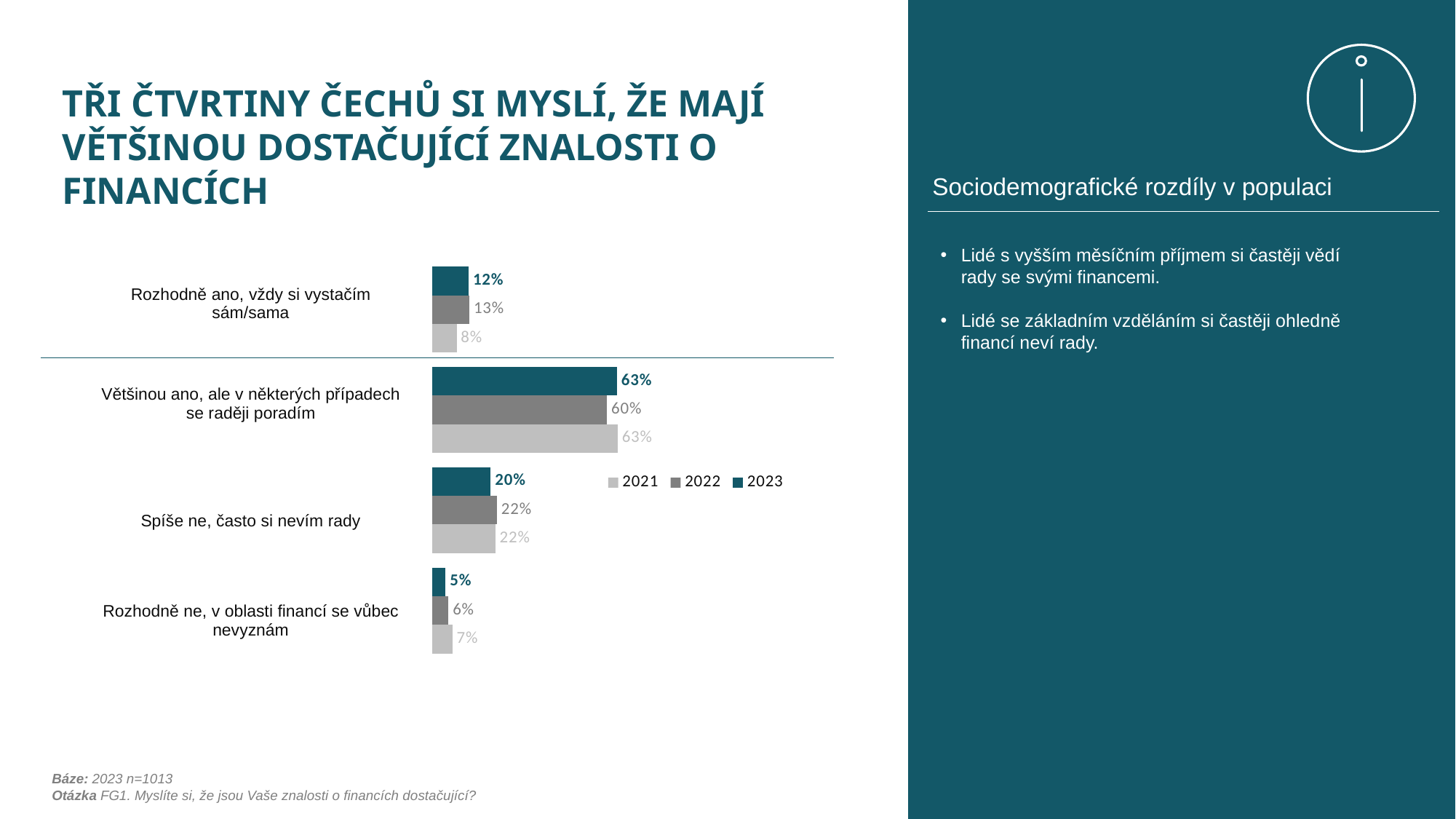
What is the 2021 value for "Rozhodně ano, vždy si vystačím sám/sama"? 8% How many series does the legend list? 3 What is the 2023 value for "Rozhodně ne, v oblasti financí se vůbec nevyznám"? 5% Which is larger for "Rozhodně ano, vždy si vystačím sám/sama": the 2022 value or the 2021 value? 2022 Which years are listed in the chart legend? 2021, 2022, 2023 What is the 2023 value for "Většinou ano, ale v některých případech se raději poradím"? 63% What kind of chart is shown on the slide? Bar chart What is the difference between the 2023 and 2022 values for "Většinou ano, ale v některých případech se raději poradím"? 3 percentage points How many response categories does the chart show? 4 Which category has the lowest 2021 value? Rozhodně ne, v oblasti financí se vůbec nevyznám What is the 2022 value for "Spíše ne, často si nevím rady"? 22% Which category has the highest 2023 value? Většinou ano, ale v některých případech se raději poradím